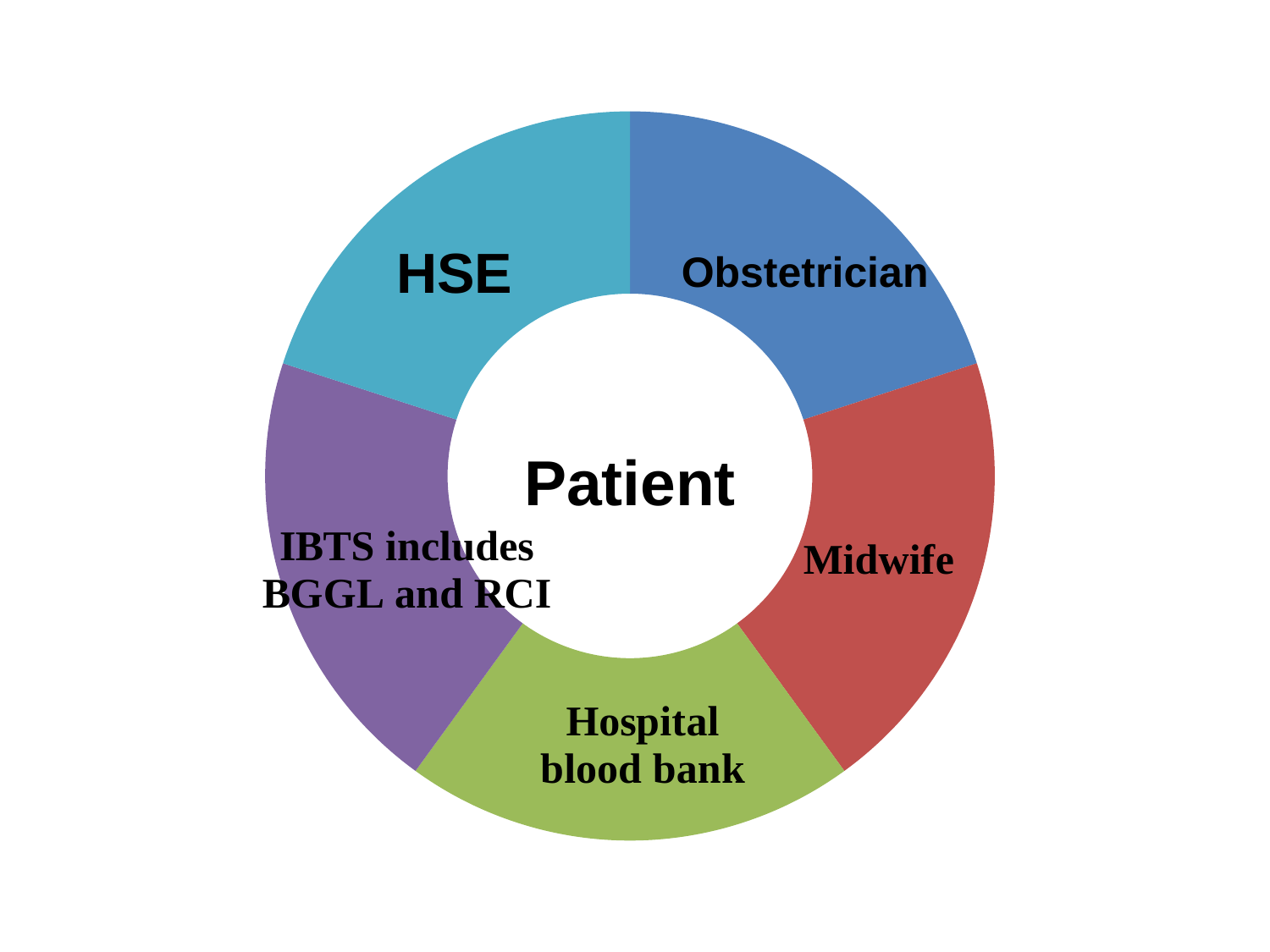
Which segment is labelled 'IBTS includes BGGL and RCI'? the purple segment Which segment sits at the top right of the doughnut chart? Obstetrician What kind of chart is shown on the slide? doughnut chart Which segment sits at the top left of the doughnut chart? HSE Which segment of the chart is labelled in green? Hospital blood bank How many segments does the doughnut chart have? 5 What word appears in the centre of the doughnut chart? Patient What colour is the segment labelled Midwife? red